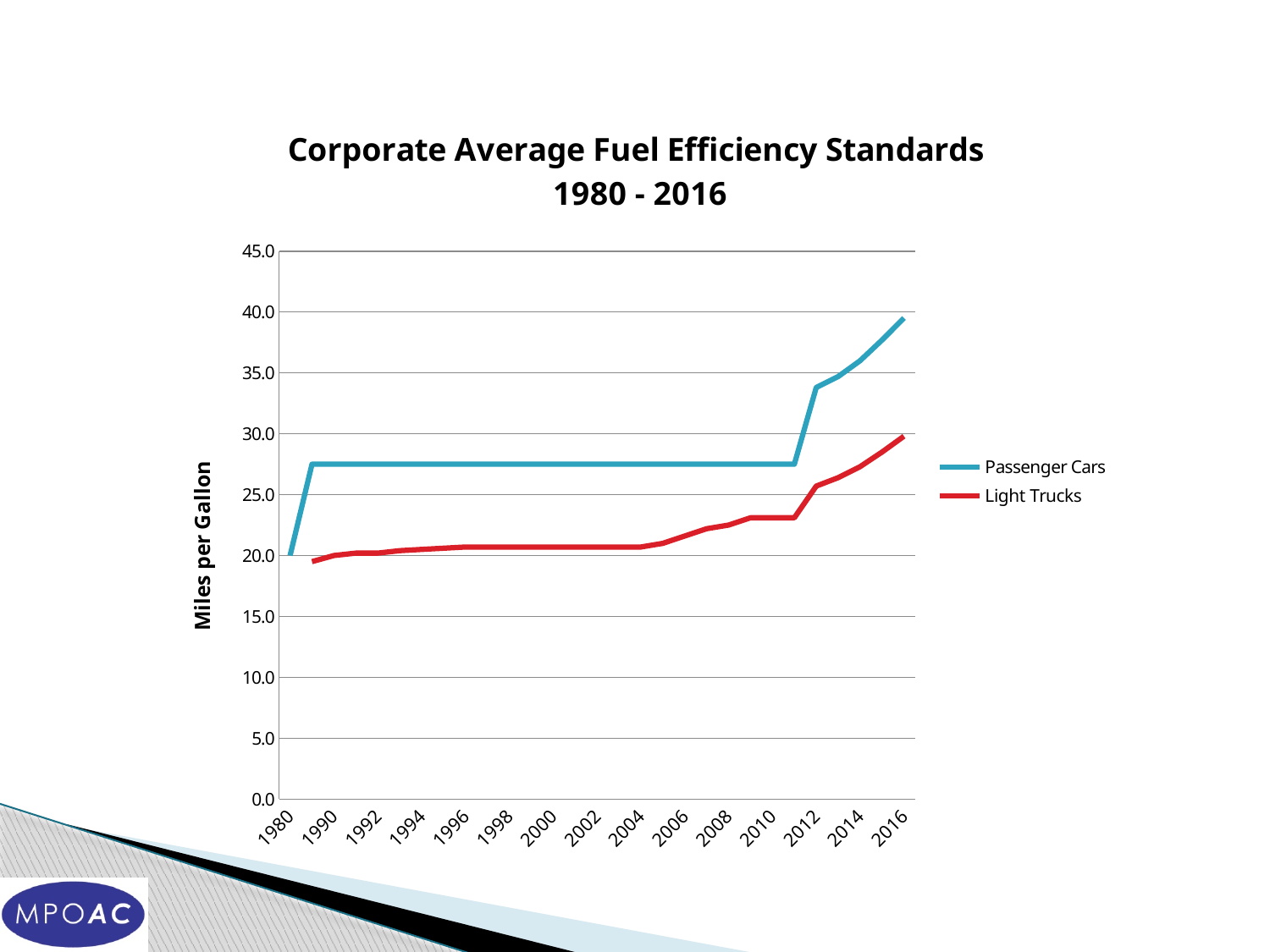
What kind of chart is shown on the slide? Line chart How many series does the legend list? 2 Is the Light Trucks value for 2000 greater or less than 25.0? less Is the Passenger Cars value for 2000 greater or less than 25.0? greater Is the Light Trucks value for 2016 greater or less than 25.0? greater Do the Passenger Cars values rise or fall between 2010 and 2016? Rise What are the two series named in the legend? Passenger Cars and Light Trucks In 2016, which series has the higher value, Passenger Cars or Light Trucks? Passenger Cars In which year does the Passenger Cars series reach its highest value? 2016 What is the label on the vertical axis? Miles per Gallon